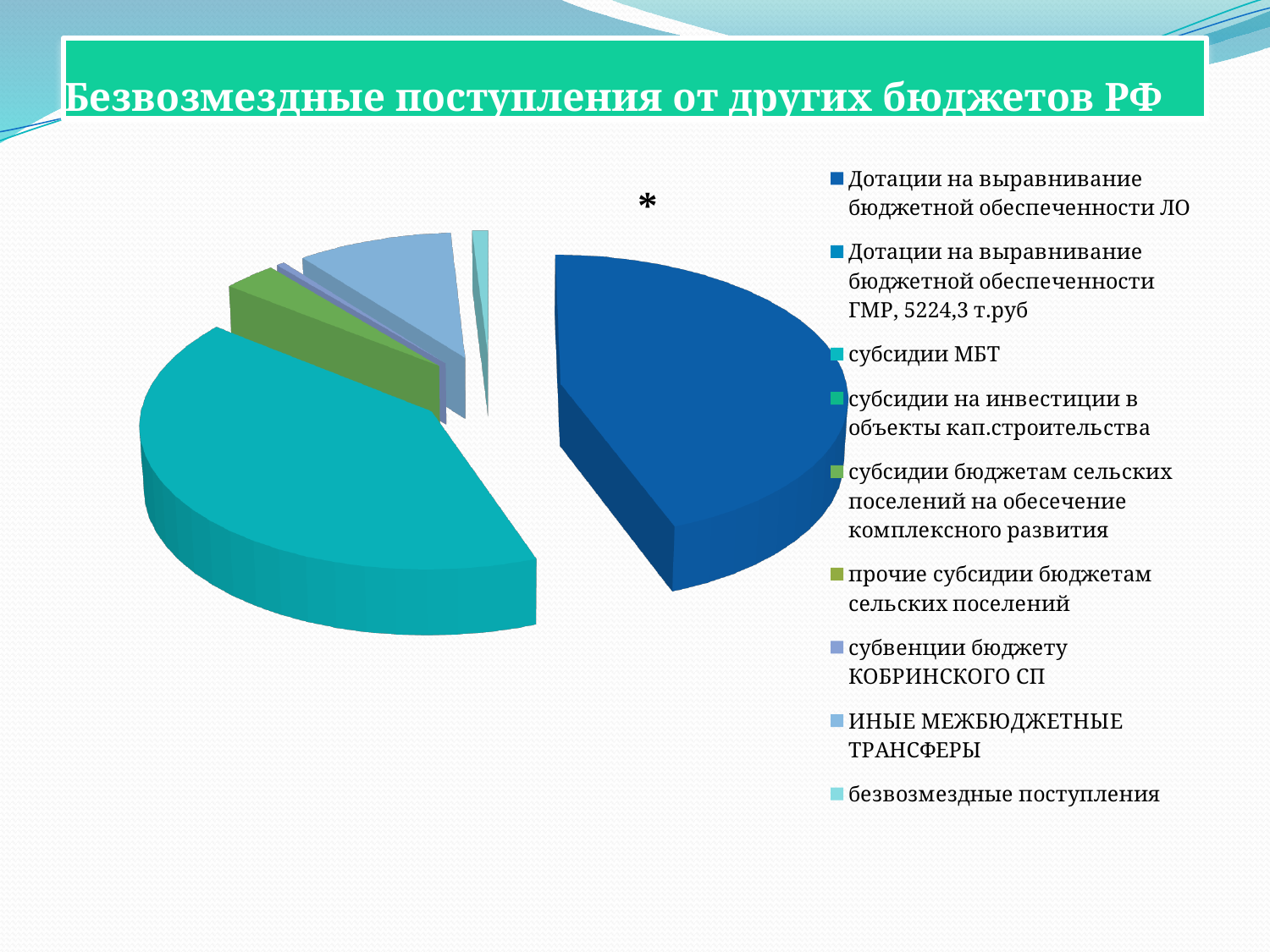
How many categories does the legend of the pie chart list? 9 Which is larger in the pie chart: the slice for субсидии МБТ or the slice for ИНЫЕ МЕЖБЮДЖЕТНЫЕ ТРАНСФЕРЫ? субсидии МБТ What is the title of the slide containing the pie chart? Безвозмездные поступления от других бюджетов РФ Which is larger in the pie chart: the slice for субсидии МБТ or the slice for субвенции бюджету КОБРИНСКОГО СП? субсидии МБТ What kind of chart is shown on the slide? pie chart Which is larger in the pie chart: the slice for Дотации на выравнивание бюджетной обеспеченности ЛО or the slice for прочие субсидии бюджетам сельских поселений? Дотации на выравнивание бюджетной обеспеченности ЛО What amount is stated in the legend entry for Дотации на выравнивание бюджетной обеспеченности ГМР? 5224,3 т.руб